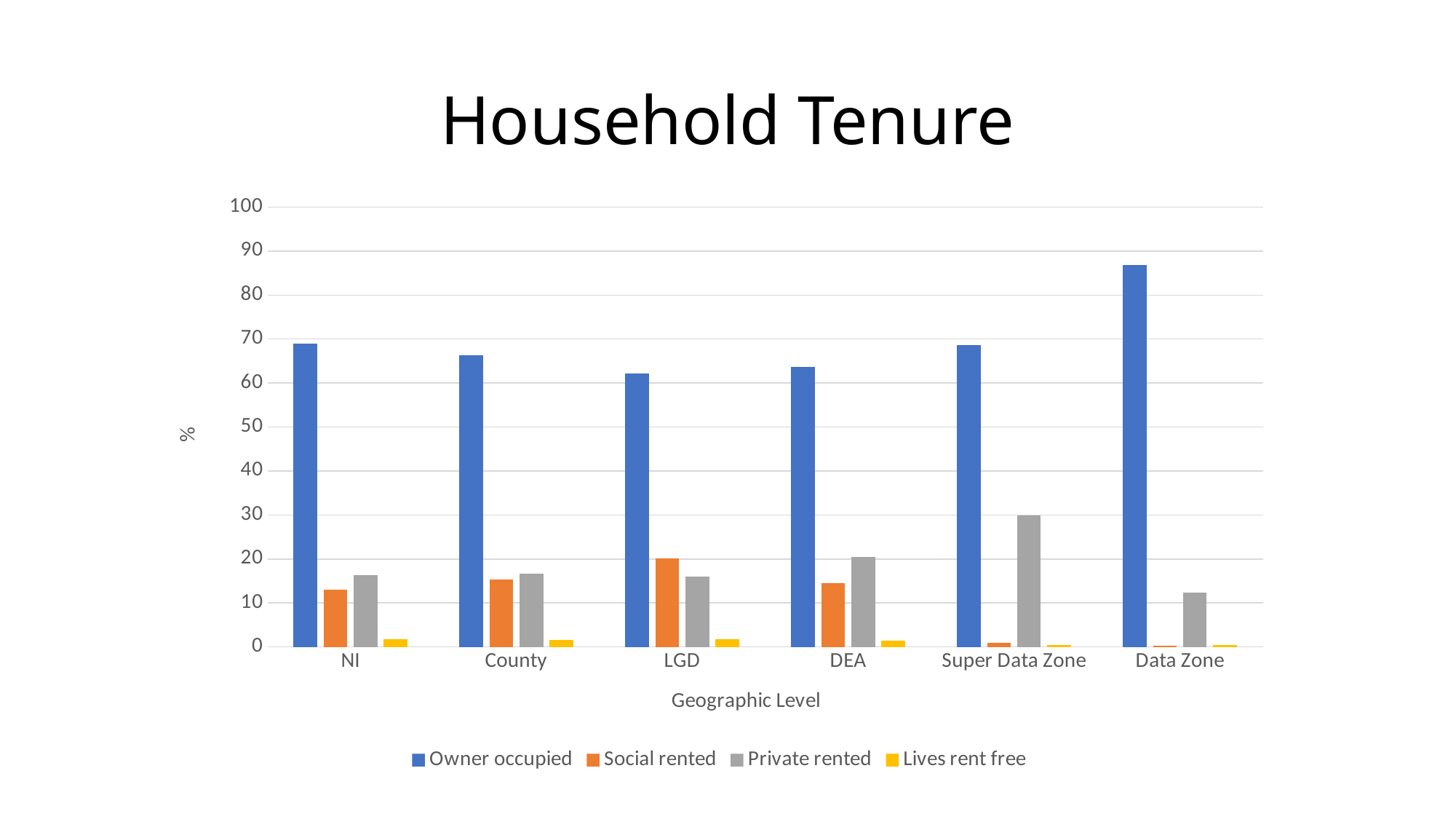
Which geographic level has the highest Private rented value? Super Data Zone Is the Social rented value for Super Data Zone greater or less than 10? less How many geographic levels are shown on the x axis? 6 What is the label of the x axis? Geographic Level For DEA, which is larger: Private rented or Social rented? Private rented Is the Owner occupied value for Data Zone greater or less than 80? greater Which geographic level has the highest Social rented value? LGD Which geographic level has the highest Owner occupied value? Data Zone How many series does the legend list? 4 Is the Private rented value for Super Data Zone greater or less than 20? greater What kind of chart is shown on the slide? bar chart Which geographic level has the lowest Private rented value? Data Zone